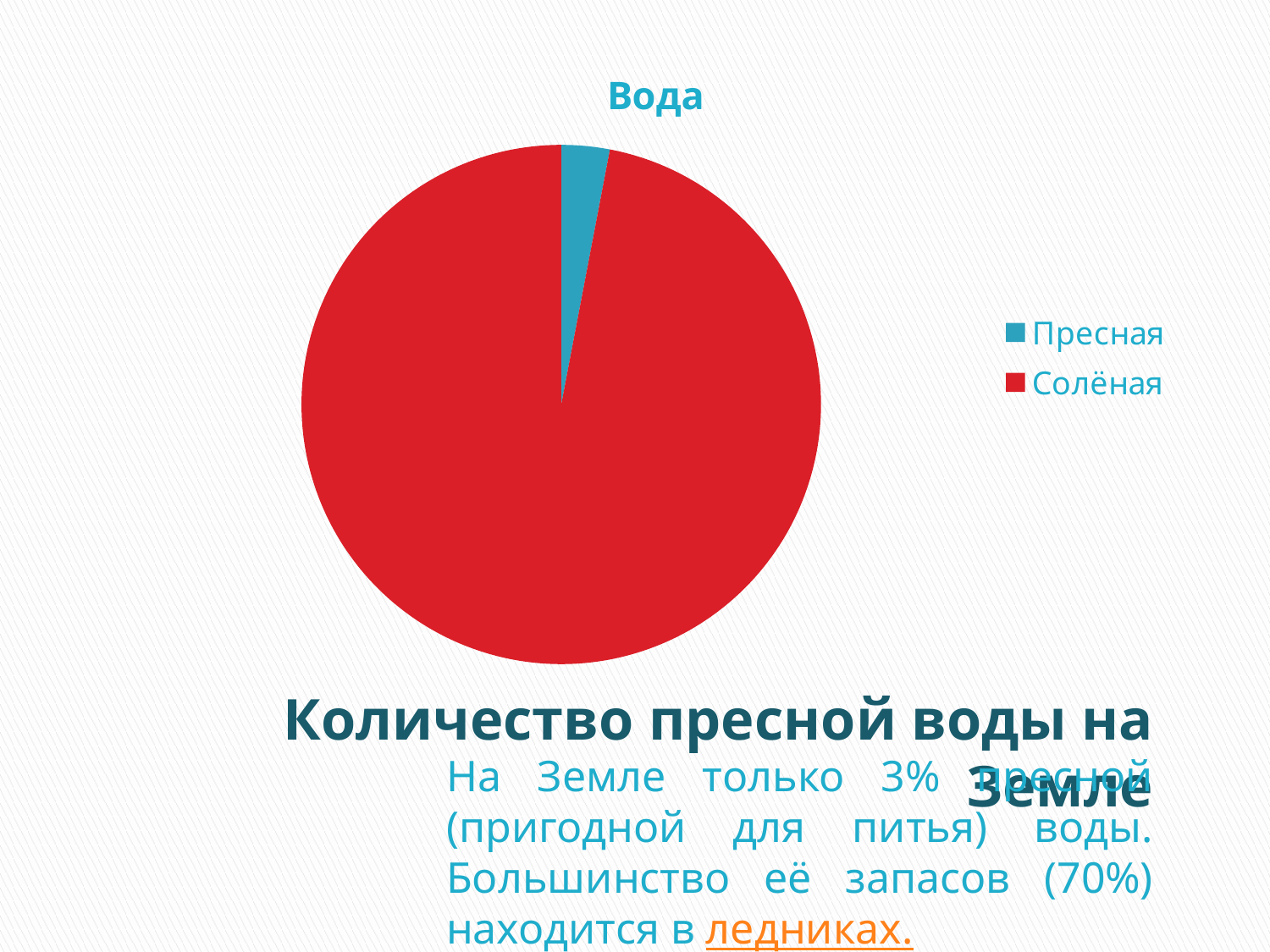
How many entries does the legend list? 2 Which category has the largest slice of the pie? Солёная What kind of chart is shown on the slide? pie chart What is the title of the chart? Вода Which category has the smallest slice of the pie? Пресная How many slices does the pie chart have? 2 What colour is the slice for Пресная? blue Which slice is larger, Пресная or Солёная? Солёная